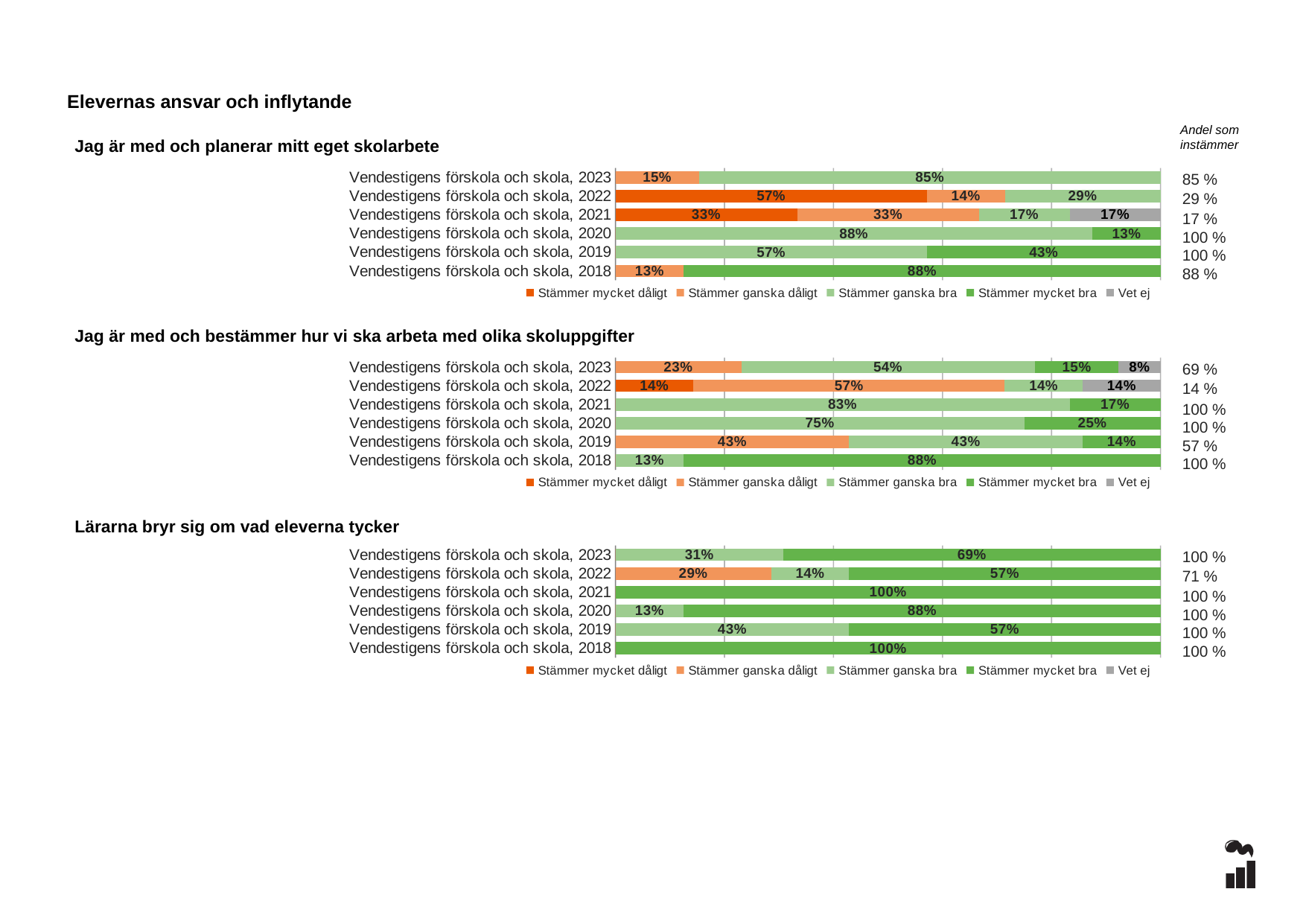
How many bars (years) are shown in the chart 'Lärarna bryr sig om vad eleverna tycker'? 6 In the chart 'Jag är med och planerar mitt eget skolarbete', what is the value for 'Stämmer mycket dåligt' for Vendestigens förskola och skola, 2022? 57% In the chart 'Jag är med och bestämmer hur vi ska arbeta med olika skoluppgifter', what is the difference between the 'Stämmer ganska bra' value for 2021 and the 'Stämmer ganska bra' value for 2020? 8% In the chart 'Jag är med och planerar mitt eget skolarbete', what is the value for 'Stämmer ganska bra' for Vendestigens förskola och skola, 2023? 85% In the chart 'Jag är med och planerar mitt eget skolarbete', which is larger: the 'Stämmer mycket bra' value for 2019 or the 'Stämmer mycket bra' value for 2020? 2019 In the chart 'Lärarna bryr sig om vad eleverna tycker', what is the value for 'Stämmer mycket bra' for Vendestigens förskola och skola, 2023? 69% In the chart 'Jag är med och planerar mitt eget skolarbete', what is the value for 'Vet ej' for Vendestigens förskola och skola, 2021? 17% How many series does the legend of the chart 'Jag är med och planerar mitt eget skolarbete' list? 5 In the chart 'Jag är med och bestämmer hur vi ska arbeta med olika skoluppgifter', what is the value for 'Stämmer mycket bra' for Vendestigens förskola och skola, 2020? 25% What type of chart is 'Lärarna bryr sig om vad eleverna tycker'? Stacked bar chart In the chart 'Jag är med och bestämmer hur vi ska arbeta med olika skoluppgifter', what is the value for 'Stämmer ganska dåligt' for Vendestigens förskola och skola, 2022? 57% In the chart 'Lärarna bryr sig om vad eleverna tycker', which year has the largest 'Stämmer ganska dåligt' segment? Vendestigens förskola och skola, 2022